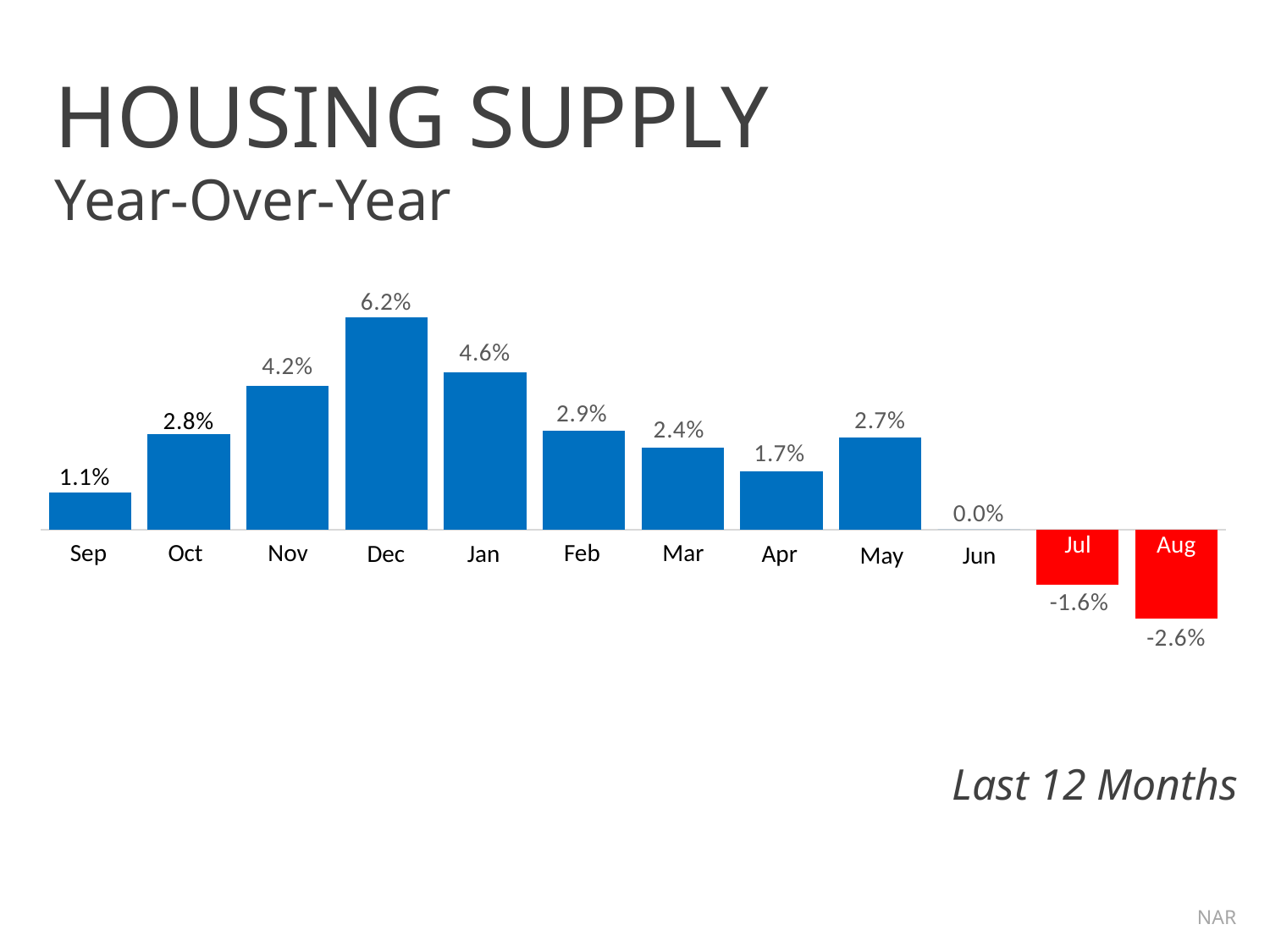
What is the difference between the values for Dec and Jan? 1.6% What is the value shown for Jun? 0.0% Which month has the lowest year-over-year value? Aug Do the values rise or fall from Dec to Aug? Fall What is the difference between the values for Nov and Oct? 1.4% What kind of chart is shown on the slide? Bar chart What is the year-over-year housing supply value for Dec? 6.2% What is the value shown for Jul? -1.6% Which month has the highest year-over-year value? Dec What colour are the bars for Jul and Aug? Red How many months are shown on the chart? 12 Which is larger, the value for Feb or the value for May? Feb